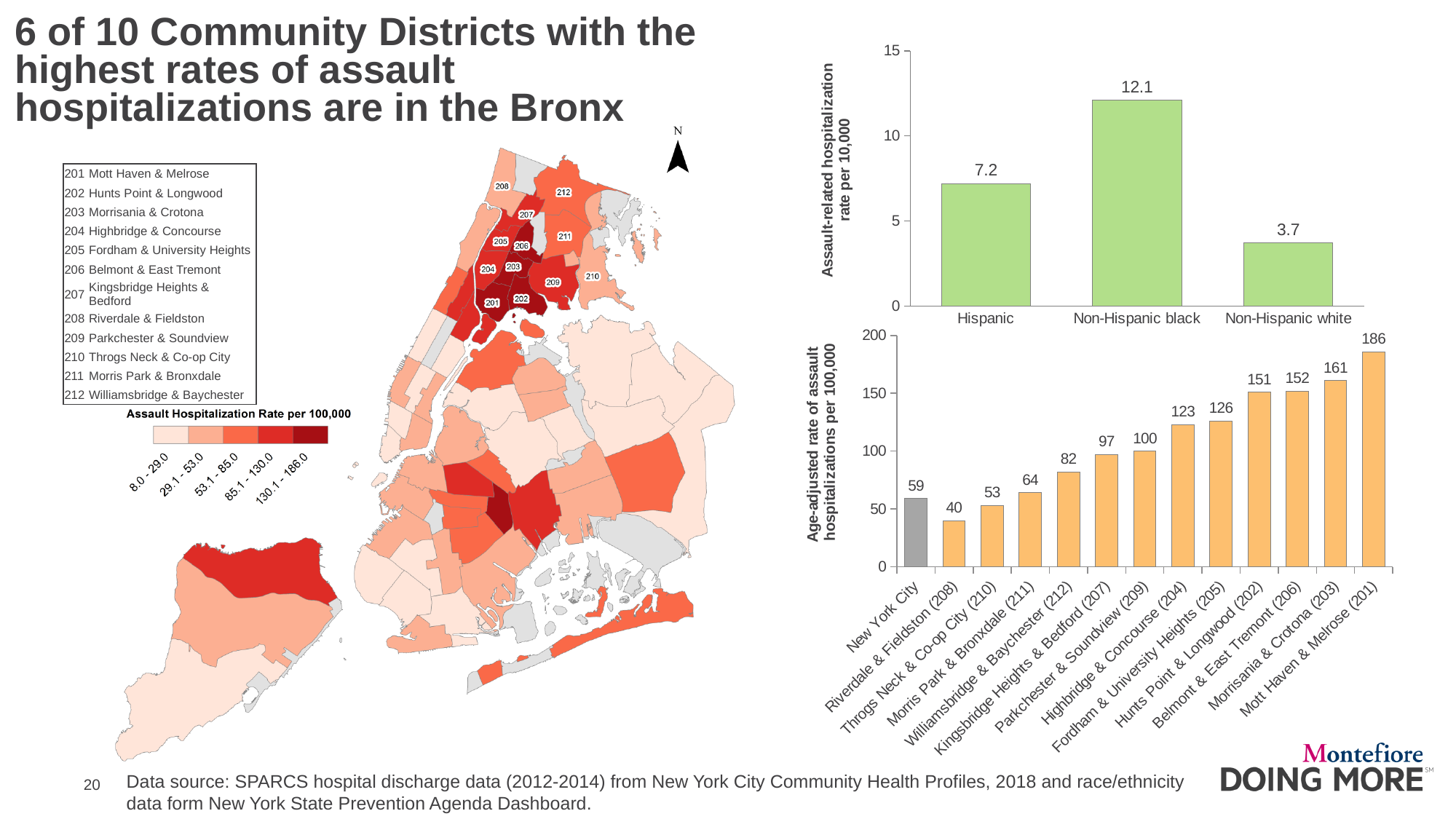
In the bottom-right bar chart, which is larger: the value for Highbridge & Concourse (204) or Parkchester & Soundview (209)? Highbridge & Concourse (204) In the bottom-right bar chart, what is the value for New York City? 59 In the bottom-right bar chart, what is the difference between the values for Morrisania & Crotona (203) and Williamsbridge & Baychester (212)? 79 What type of chart is the bottom-right chart? bar chart In the bottom-right chart, do the values generally rise or fall from left to right after the New York City bar? rise In the bottom-right bar chart, what is the age-adjusted rate of assault hospitalizations per 100,000 for Mott Haven & Melrose (201)? 186 In the top-right bar chart, what is the difference between the rates for Non-Hispanic black and Hispanic? 4.9 In the top-right bar chart, what is the assault-related hospitalization rate per 10,000 for Non-Hispanic black? 12.1 In the top-right bar chart, which group has the lowest assault-related hospitalization rate? Non-Hispanic white How many bars are shown in the bottom-right bar chart? 13 In the bottom-right bar chart, which community district has the lowest age-adjusted rate of assault hospitalizations? Riverdale & Fieldston (208) How many categories are shown in the top-right bar chart? 3